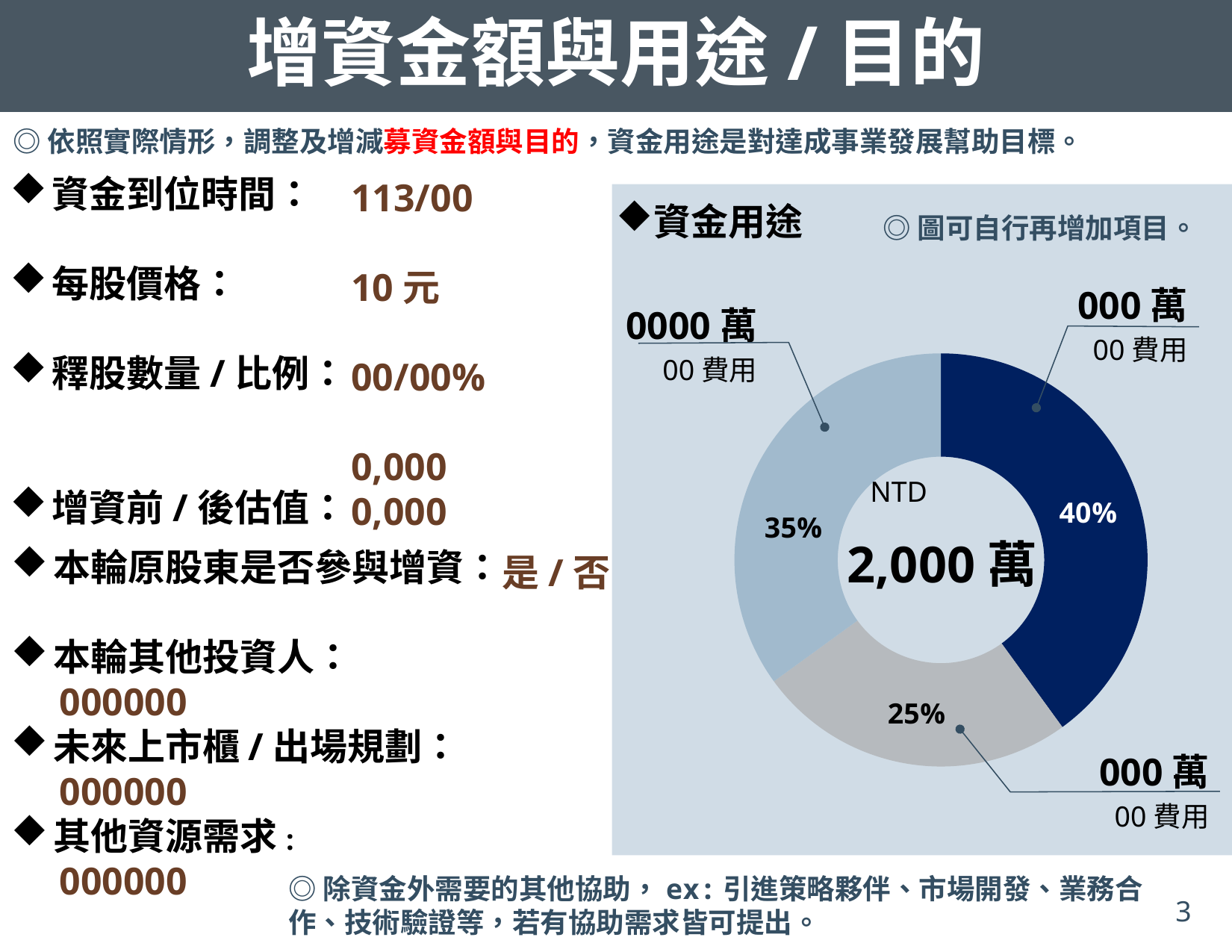
Which slice of the donut chart has the largest share? The dark navy slice (40%) What is the difference in percentage points between the largest slice (40%) and the smallest slice (25%) of the donut chart? 15 percentage points How many slices does the donut chart have? 3 What is the heading printed above the donut chart? 資金用途 What is the sum of the three percentages shown on the donut chart? 100% What kind of chart is shown under the heading 資金用途? Donut (pie) chart What percentage is shown on the grey slice of the donut chart? 25% What total amount is printed in the centre of the donut chart? NTD 2,000 萬 Which is larger in the donut chart, the light blue slice or the grey slice? The light blue slice (35%) What percentage is shown on the dark navy slice of the donut chart? 40% Which slice of the donut chart has the smallest share? The grey slice (25%) What percentage is shown on the light blue slice of the donut chart? 35%